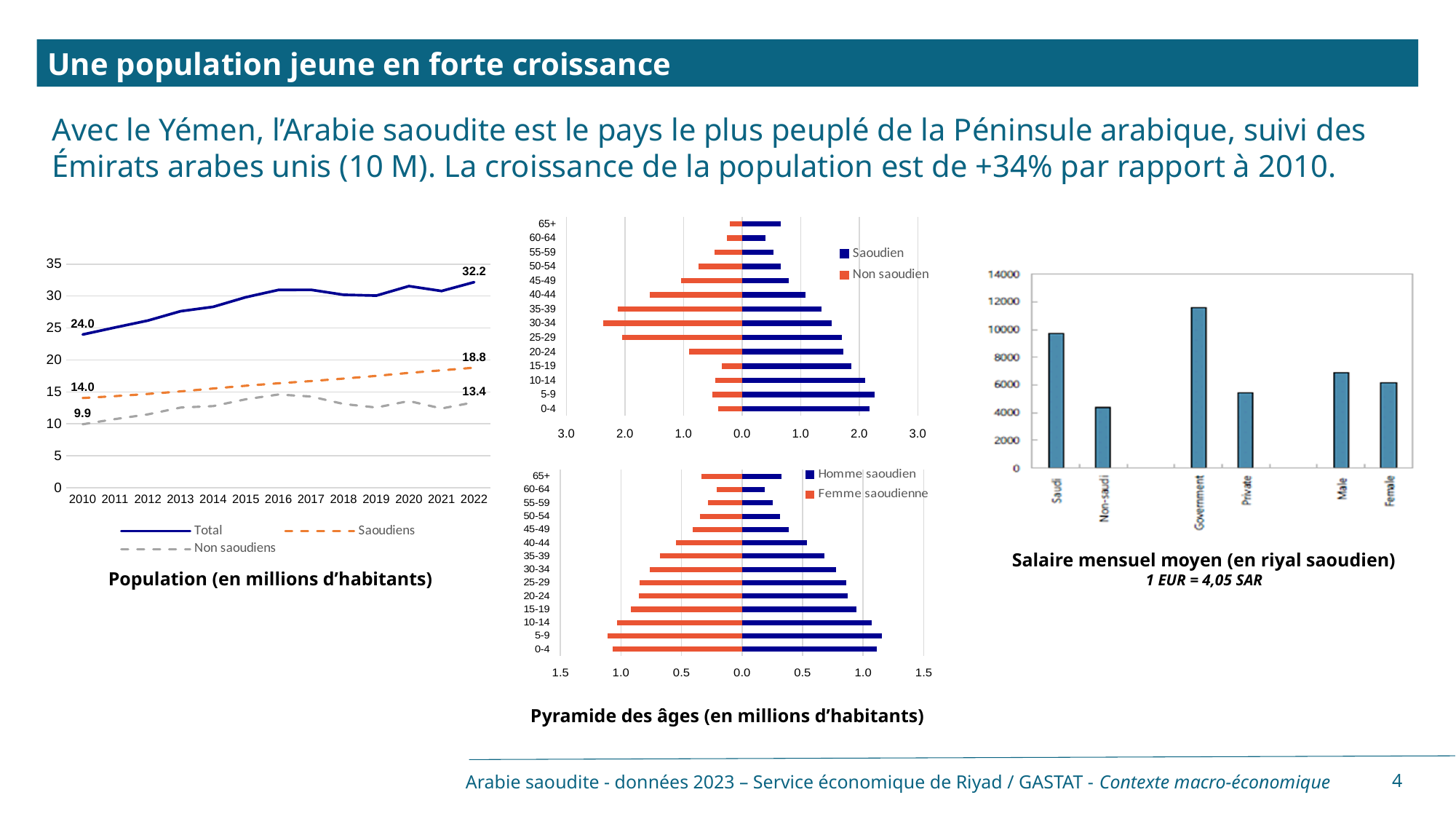
In the upper 'Pyramide des âges' chart (Saoudien / Non saoudien), is the Non saoudien value for the 30-34 age group greater or less than 2.0? greater In the 'Population (en millions d'habitants)' chart, what is the value of the Total series in 2022? 32.2 In the 'Salaire mensuel moyen (en riyal saoudien)' chart, which category has the highest value? Government In the 'Population (en millions d'habitants)' chart, does the Total series rise or fall from 2010 to 2022? rise In the 'Salaire mensuel moyen (en riyal saoudien)' chart, which is larger, the value for Saudi or the value for Non-saudi? Saudi In the 'Population (en millions d'habitants)' chart, what is the value of the Non saoudiens series in 2022? 13.4 In the 'Population (en millions d'habitants)' chart, what is the value of the Saoudiens series in 2010? 14.0 In the 'Population (en millions d'habitants)' chart, by how much did the Total series increase between 2010 and 2022? 8.2 In the 'Population (en millions d'habitants)' chart, how many years are shown on the x axis? 13 In the 'Salaire mensuel moyen (en riyal saoudien)' chart, which category has the lowest value? Non-saudi In the 'Salaire mensuel moyen (en riyal saoudien)' chart, is the value for Private greater or less than 6000? less In the 'Population (en millions d'habitants)' chart, how many series does the legend list? 3